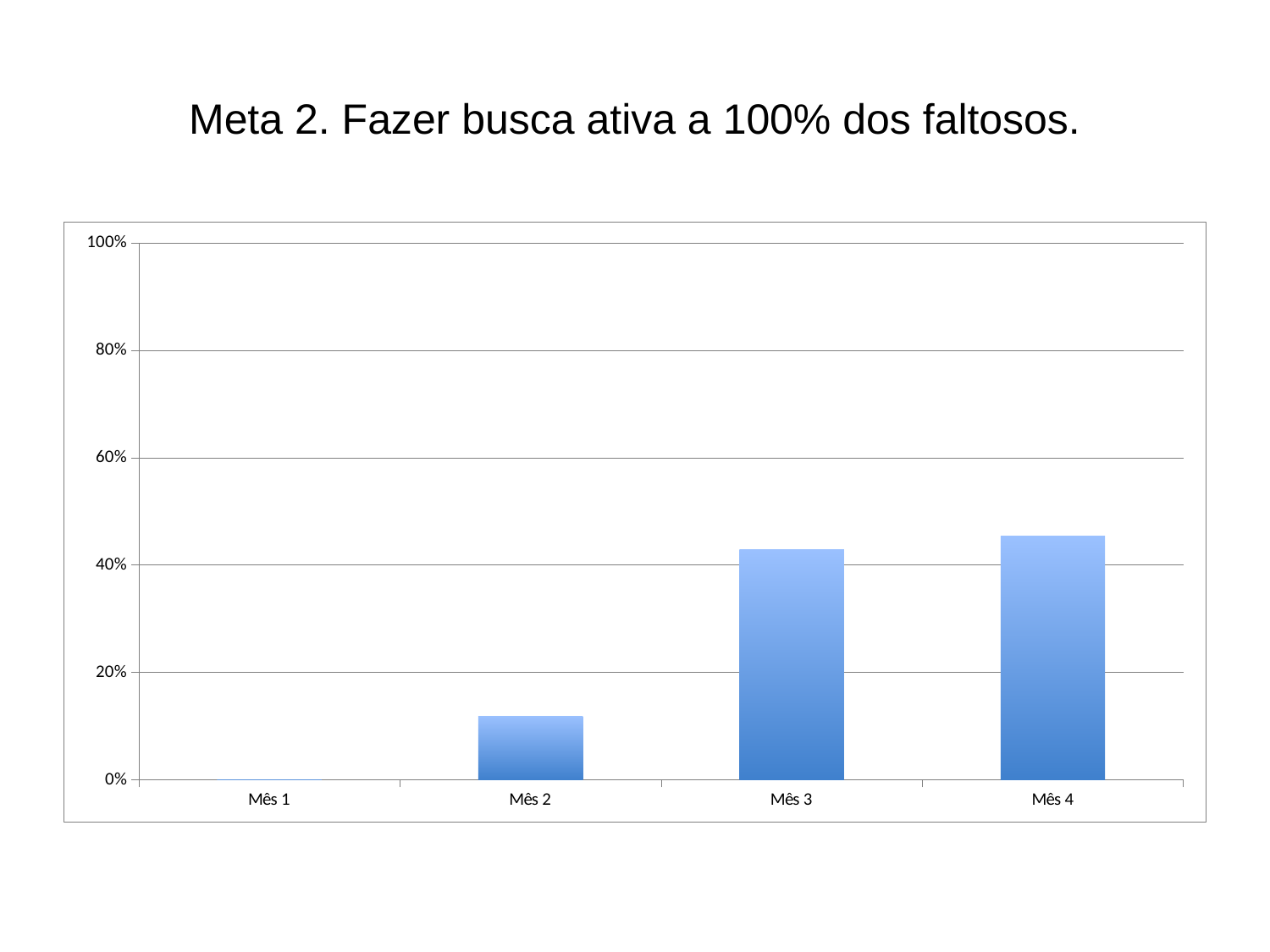
Do the values rise or fall from Mês 1 to Mês 4? rise What is the title of the slide containing the chart? Meta 2. Fazer busca ativa a 100% dos faltosos. Which is larger, the value for Mês 2 or the value for Mês 3? Mês 3 Is the value for Mês 3 greater or less than 60%? less Is the value for Mês 2 greater or less than 20%? less Is the value for Mês 4 greater or less than 60%? less How many categories (months) are shown on the x axis of the chart? 4 What is the highest value shown on the chart's y axis? 100% What kind of chart is shown on the slide? bar chart Which month has the lowest value in the chart? Mês 1 Which month has the highest value in the chart? Mês 4